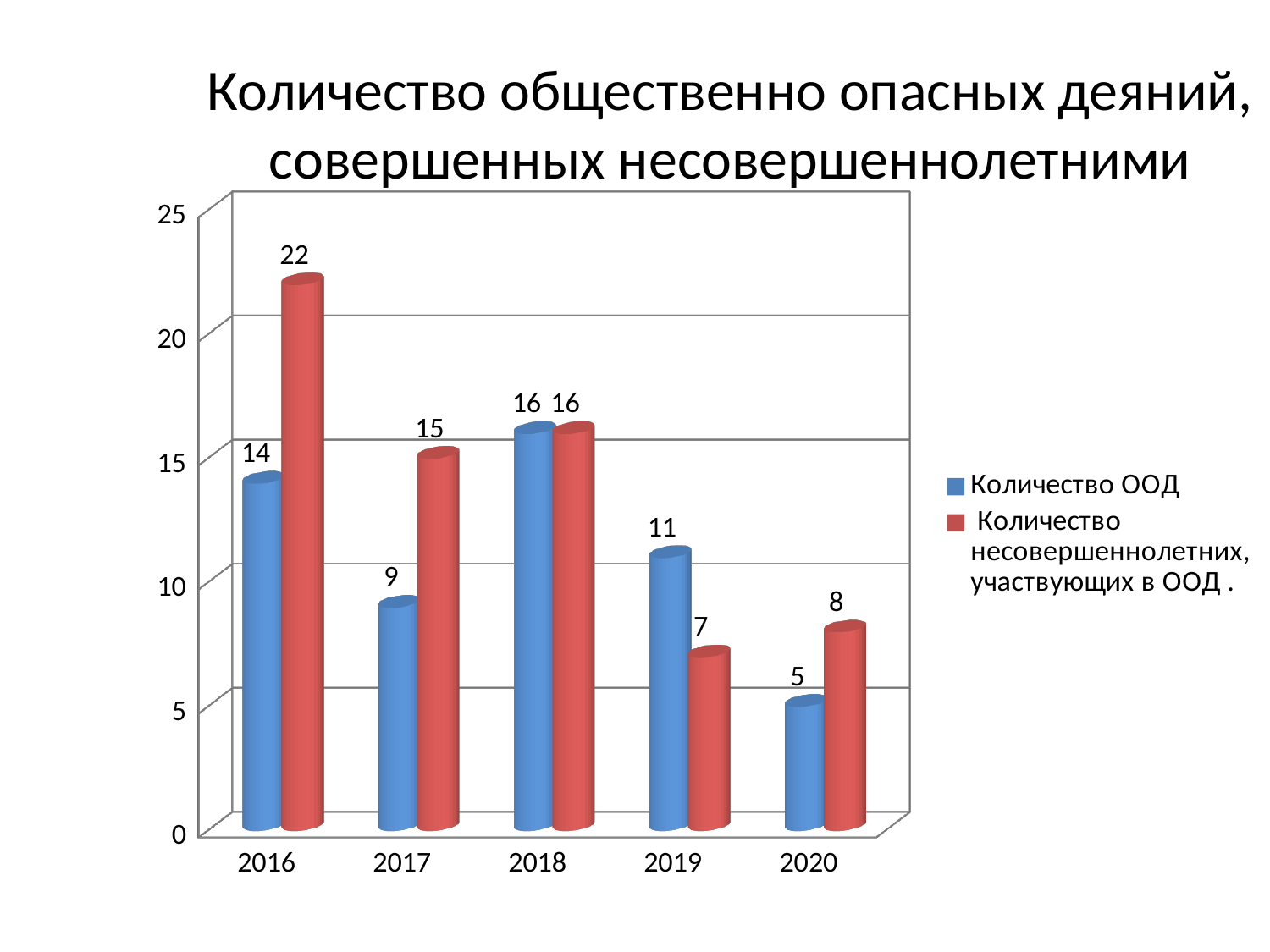
What colour are the bars for "Количество ООД"? Blue What is the difference between "Количество несовершеннолетних, участвующих в ООД" and "Количество ООД" in 2016? 8 How many series does the legend list? 2 What is the value of "Количество несовершеннолетних, участвующих в ООД" for 2017? 15 Which is larger in 2019: "Количество ООД" or "Количество несовершеннолетних, участвующих в ООД"? Количество ООД Does "Количество ООД" rise or fall from 2018 to 2020? Fall What is the value of "Количество ООД" for 2016? 14 What is the value of "Количество ООД" for 2020? 5 What kind of chart is shown on the slide? Bar chart In which year is "Количество ООД" lowest? 2020 How many years are shown on the x axis? 5 In which year is "Количество несовершеннолетних, участвующих в ООД" highest? 2016